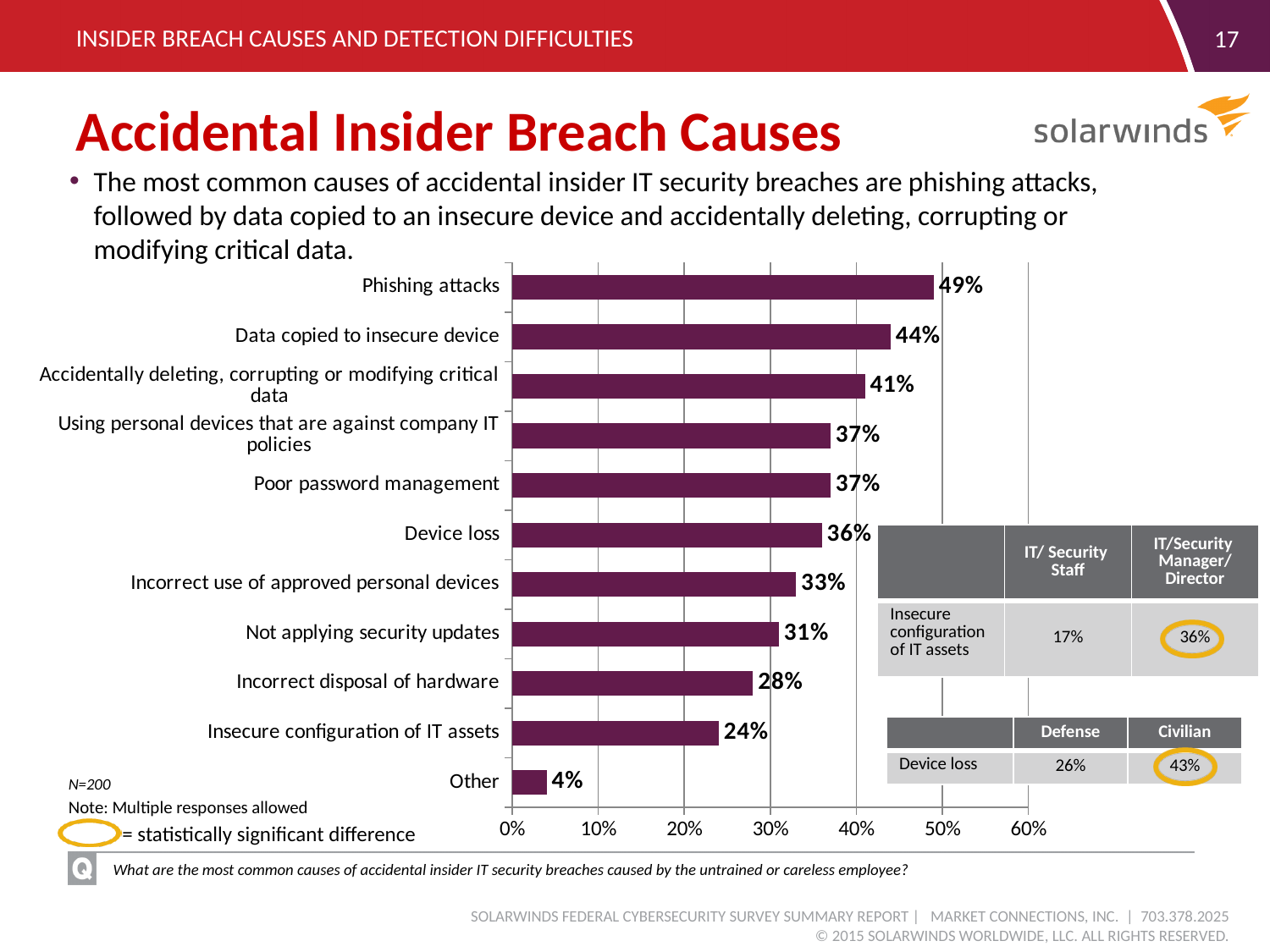
Which category has the lowest value? Other What is the difference between Device loss and Other? 32% Which category has the highest value? Phishing attacks What percentage is shown for Phishing attacks? 49% What is the highest value shown on the percentage axis? 60% What is the value for Incorrect disposal of hardware? 28% What is the value for Insecure configuration of IT assets? 24% Which is larger, Not applying security updates or Incorrect use of approved personal devices? Incorrect use of approved personal devices What is the difference between Phishing attacks and Data copied to insecure device? 5% Is the value for Poor password management greater or less than 30%? greater How many categories are plotted in the chart? 11 What kind of chart is shown on the slide? Bar chart